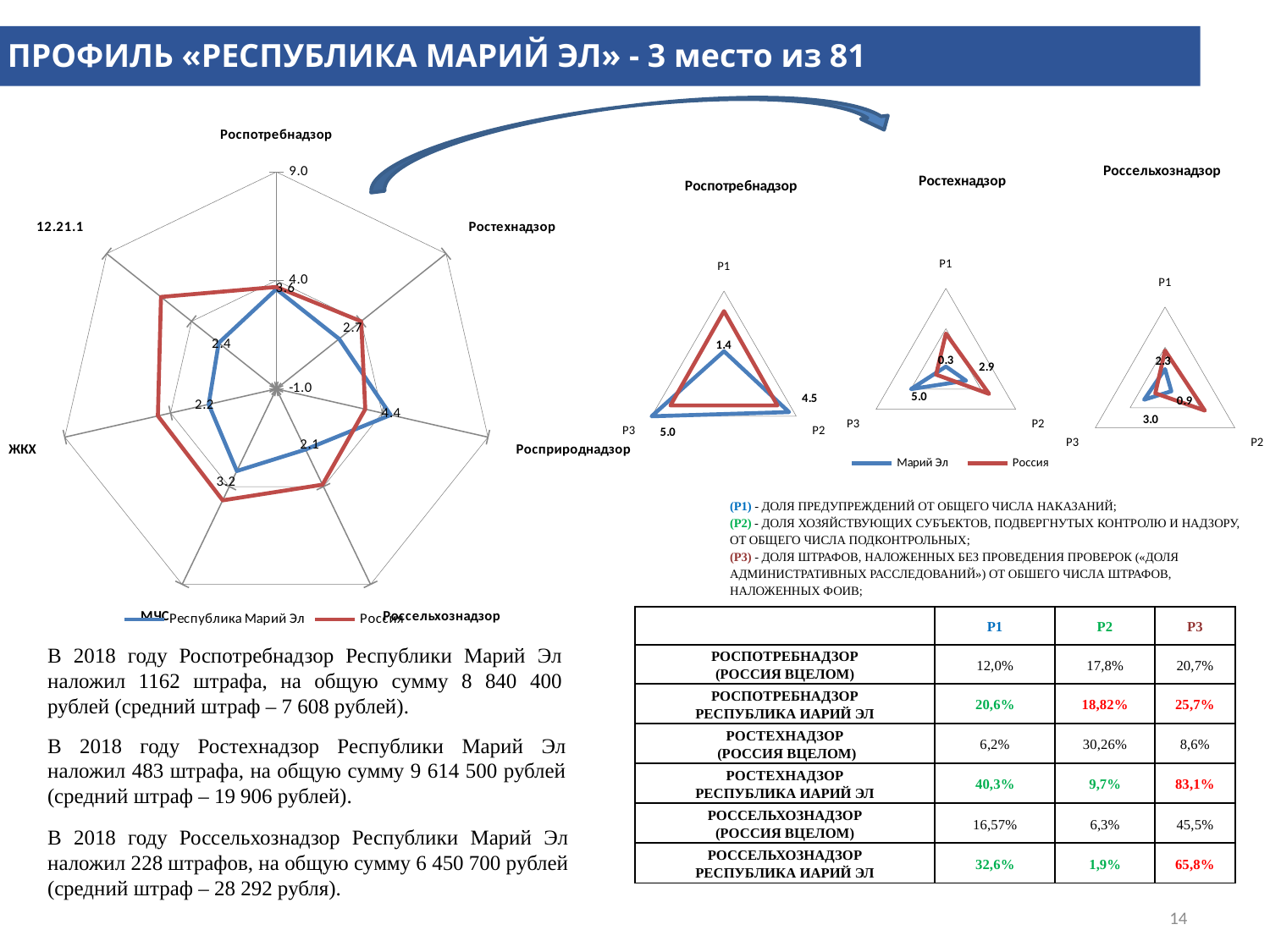
On the large radar chart on the left, which series extends further along the Росприроднадзор axis, Республика Марий Эл or Россия? Республика Марий Эл What are the two series named in the legend of the three small radar charts on the right? Марий Эл and Россия On the small Россельхознадзор radar chart, what value is labelled at the P3 axis? 3.0 How many series does the legend of the large radar chart on the left list? 2 On the small Ростехнадзор radar chart, what value is labelled at the P3 axis? 5.0 On the large radar chart on the left, which series extends further along the ЖКХ axis, Республика Марий Эл or Россия? Россия How many axes (categories) does the large radar chart on the left have? 7 What kind of chart is the large chart on the left of the slide? Radar chart On the small Роспотребнадзор radar chart, which series extends further along the P1 axis, Марий Эл or Россия? Россия How many axes does each of the three small radar charts on the right have? 3 What are the two series named in the legend of the large radar chart on the left? Республика Марий Эл and Россия